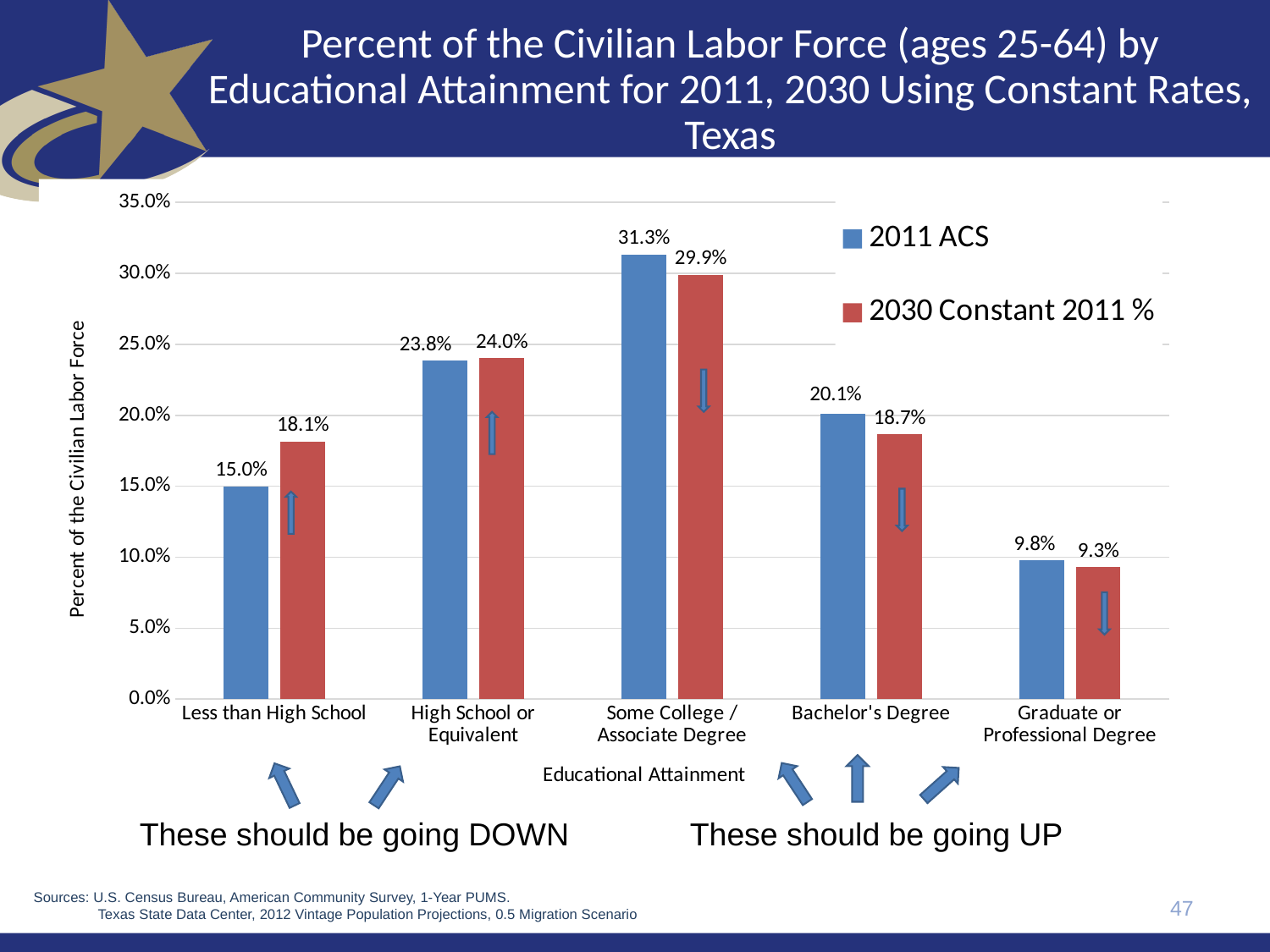
Which educational attainment category has the highest 2011 ACS value? Some College / Associate Degree For High School or Equivalent, which is larger: the 2011 ACS value or the 2030 Constant 2011 % value? 2030 Constant 2011 % What is the difference between the 2030 Constant 2011 % and 2011 ACS values for Less than High School? 3.1% What is the 2030 Constant 2011 % value for Some College / Associate Degree? 29.9% What is the 2011 ACS value for Less than High School? 15.0% What is the label of the y axis? Percent of the Civilian Labor Force What kind of chart is shown on the slide? Bar chart Which educational attainment category has the lowest 2030 Constant 2011 % value? Graduate or Professional Degree How many educational attainment categories are shown on the x axis? 5 What is the difference between the 2011 ACS and 2030 Constant 2011 % values for Bachelor's Degree? 1.4% What is the 2030 Constant 2011 % value for Bachelor's Degree? 18.7% How many series does the legend list? 2